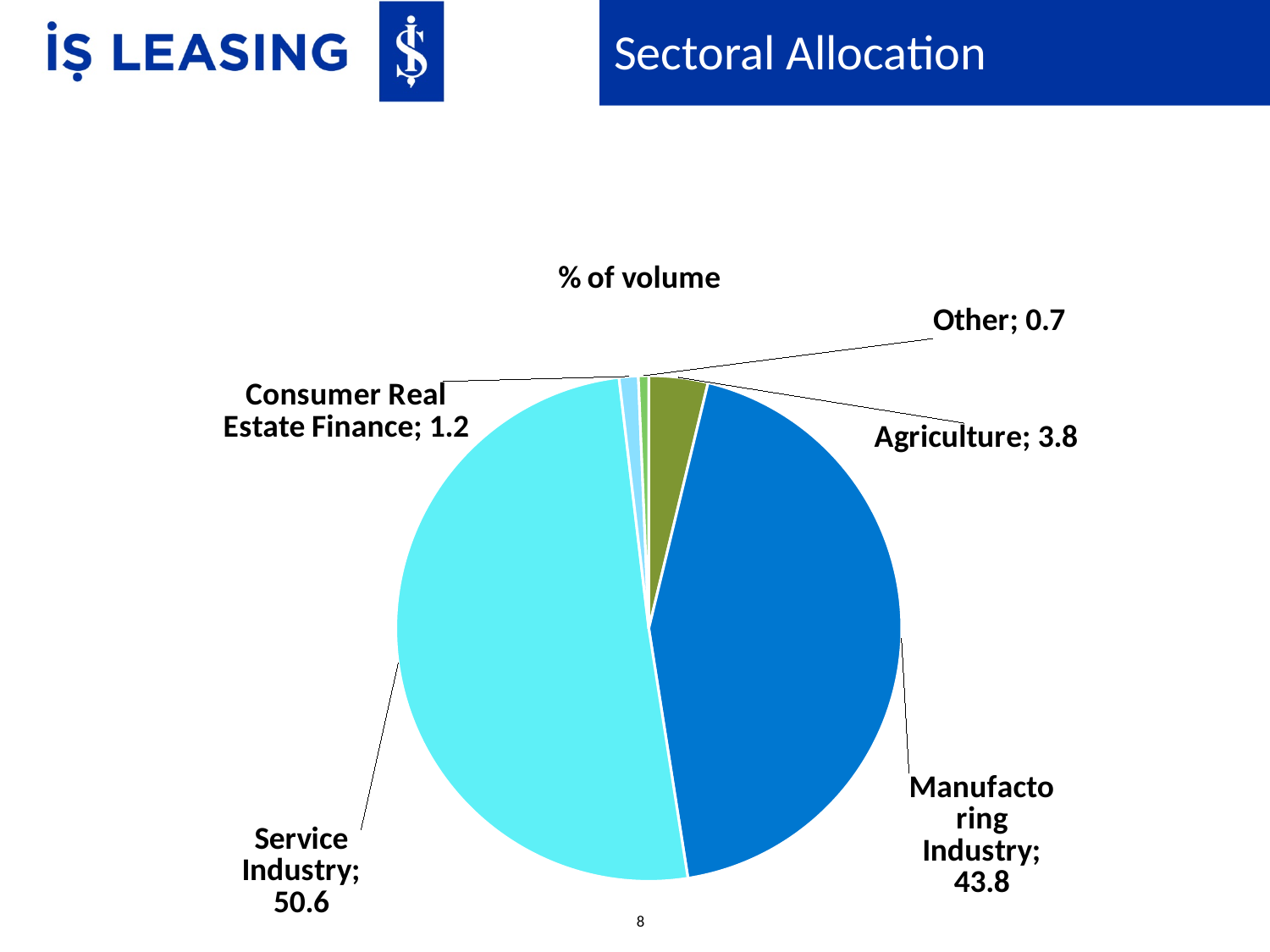
What is the difference between the values for Service Industry and Manufactoring Industry? 6.8 What is the value for Agriculture? 3.8 Which is larger, Agriculture or Consumer Real Estate Finance? Agriculture What is the value for Manufactoring Industry? 43.8 What is the value for Other? 0.7 How many categories are shown in the pie chart? 5 What is the value for Service Industry? 50.6 What is the value for Consumer Real Estate Finance? 1.2 Which category has the smallest share of the pie? Other What is the title of the chart? % of volume What type of chart is shown on the slide? pie chart Which category has the largest share of the pie? Service Industry